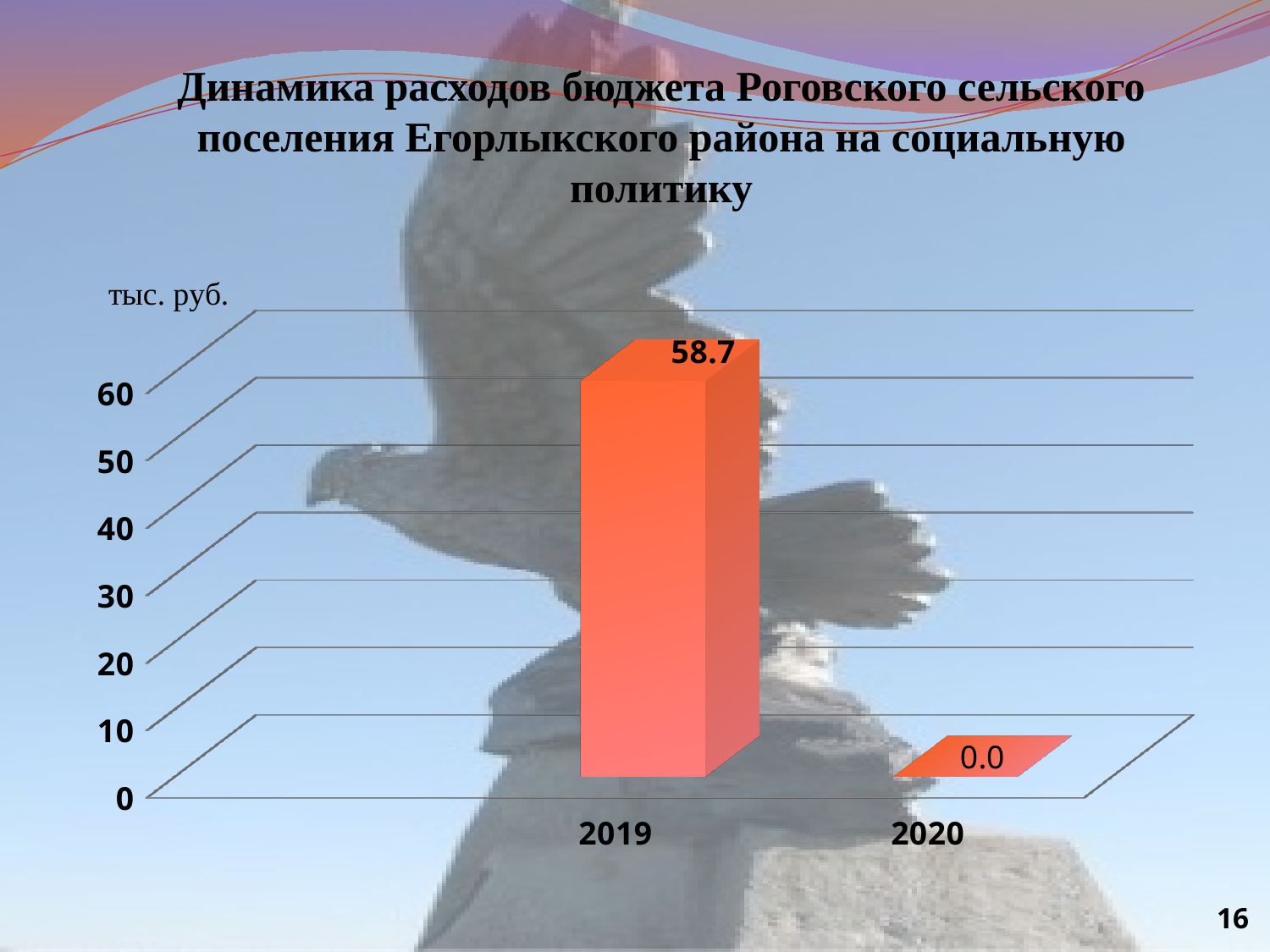
What is the difference between the values for 2019 and 2020? 58.7 What is the value for 2020? 0.0 What unit is indicated above the vertical axis? тыс. руб. Which year has the lowest value? 2020 Which year has the highest value? 2019 How many years are shown on the x axis? 2 Which is larger, the value for 2019 or the value for 2020? 2019 Is the value for 2019 greater or less than 50? greater What kind of chart is shown on the slide? bar chart Do the values rise or fall from 2019 to 2020? fall What is the highest tick value shown on the vertical axis? 60 What is the value for 2019? 58.7